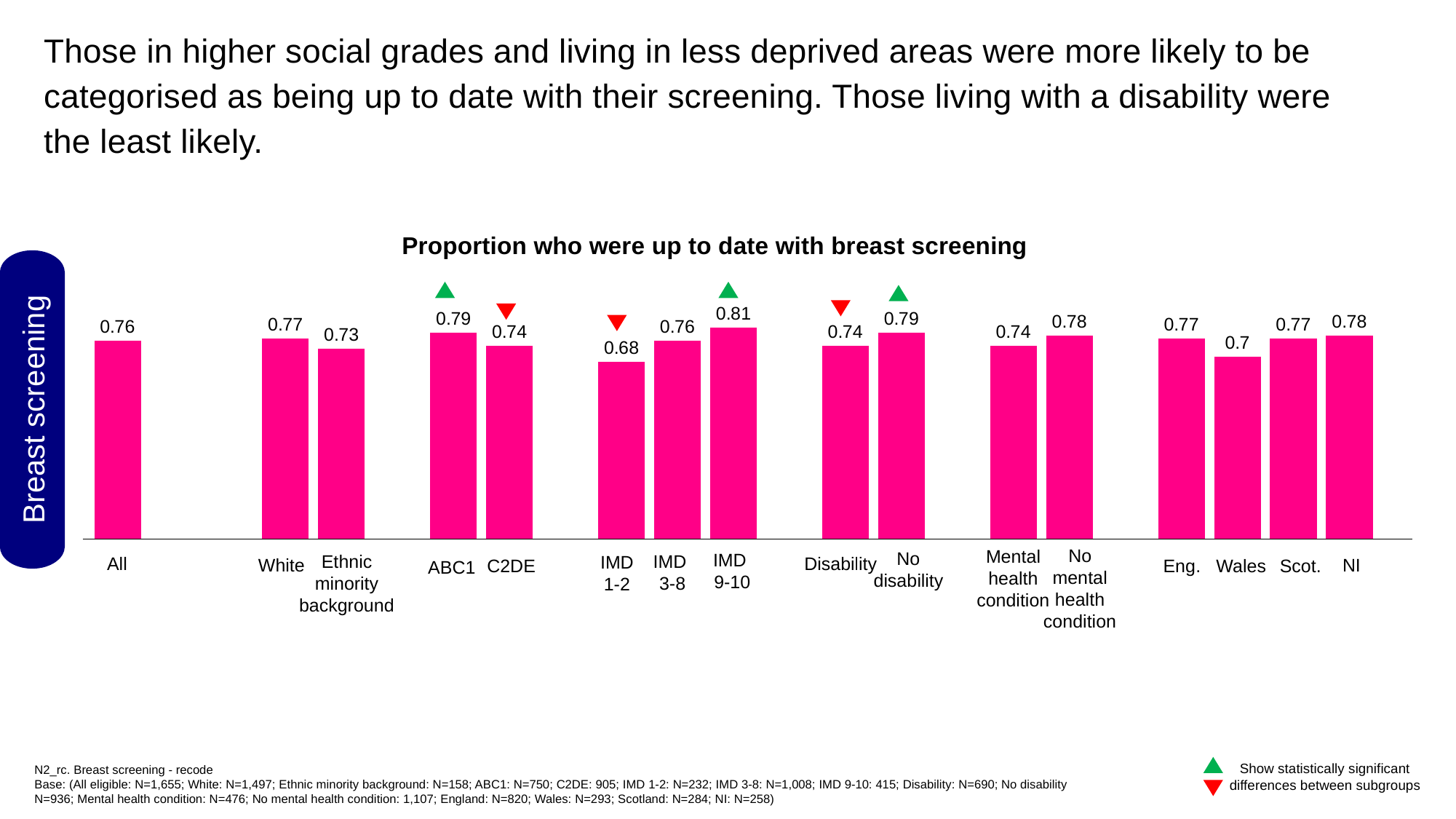
What is the value for Wales? 0.7 What is the value for No mental health condition? 0.78 What is the value for All in the chart? 0.76 What is the value for IMD 1-2? 0.68 What is the difference between the values for ABC1 and C2DE? 0.05 How many bars are shown in the chart? 16 What type of chart is shown on the slide? Bar chart What is the title of the chart? Proportion who were up to date with breast screening What is the difference between the values for IMD 9-10 and IMD 1-2? 0.13 Which has a higher value, Wales or NI? NI Which category has the highest proportion up to date with breast screening? IMD 9-10 Which category has the lowest proportion up to date with breast screening? IMD 1-2